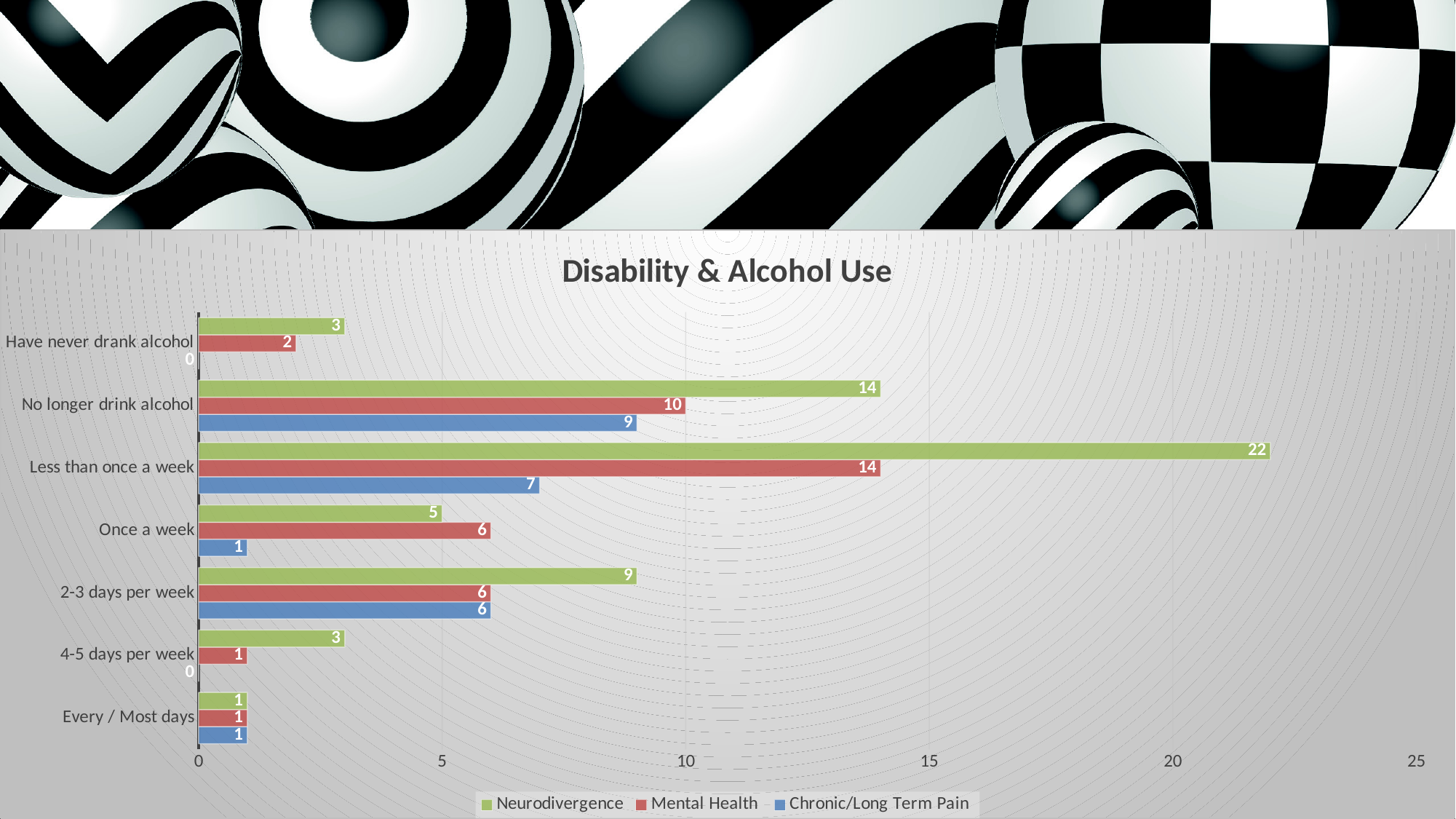
What is the Chronic/Long Term Pain value for 'No longer drink alcohol'? 9 What kind of chart is shown on the slide? Bar chart How many series does the legend list? 3 Is the Neurodivergence value for 'No longer drink alcohol' greater or less than 10? greater What is the Mental Health value for 'Once a week'? 6 What is the difference between the Neurodivergence and Mental Health values for 'Less than once a week'? 8 What is the title of the chart? Disability & Alcohol Use How many categories are shown on the chart? 7 What is the Neurodivergence value for 'Less than once a week'? 22 Which category has the highest Neurodivergence value? Less than once a week Which is larger for 'No longer drink alcohol': the Mental Health value or the Chronic/Long Term Pain value? Mental Health